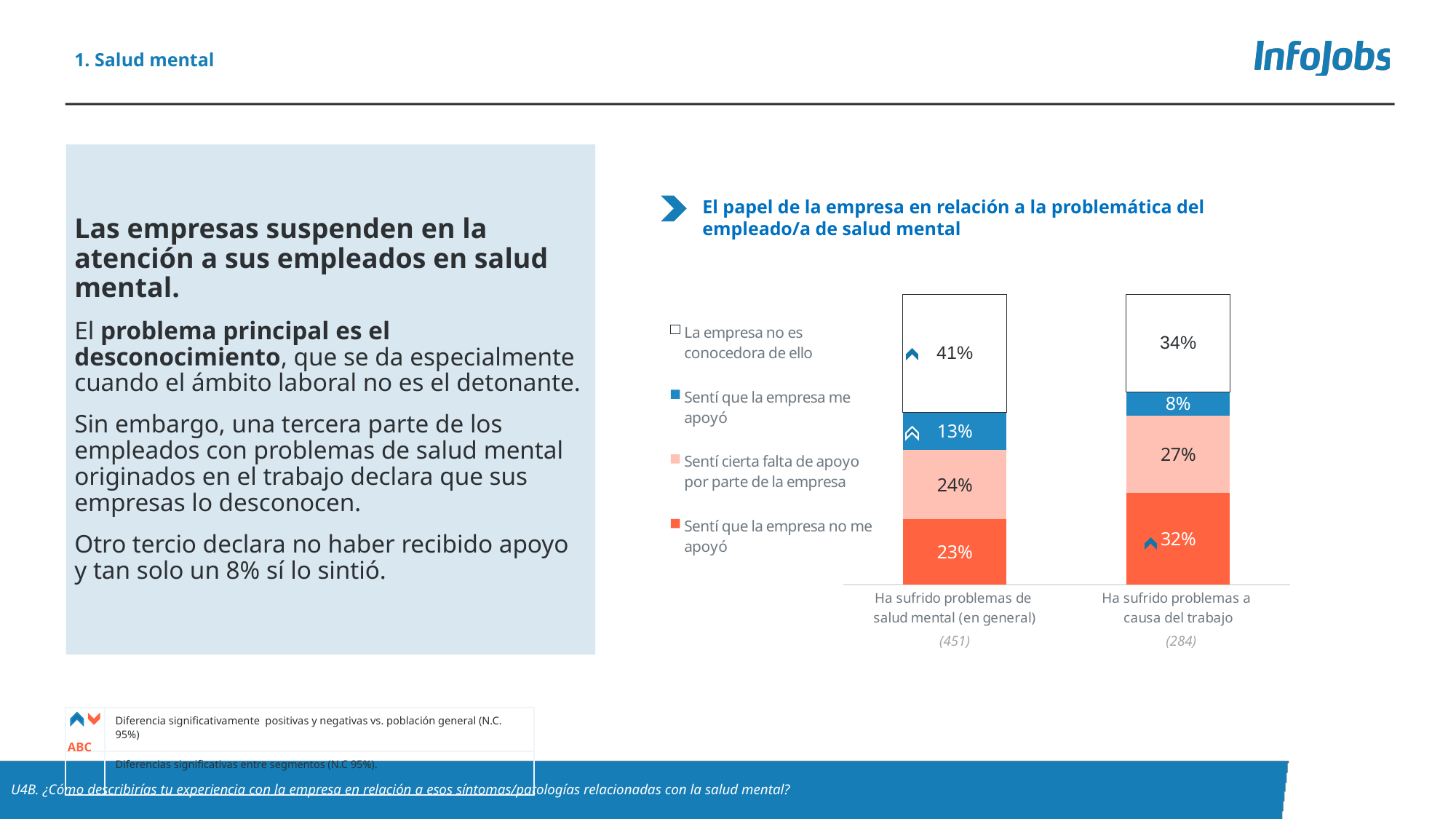
What kind of chart is shown on the slide? Stacked bar chart Which segment is the largest in the "Ha sufrido problemas a causa del trabajo" bar? La empresa no es conocedora de ello What is the value for "Sentí cierta falta de apoyo por parte de la empresa" in the "Ha sufrido problemas a causa del trabajo" bar? 27% What is the value for "Sentí que la empresa no me apoyó" in the "Ha sufrido problemas de salud mental (en general)" bar? 23% How many series does the legend list? 4 Which segment is the smallest in the "Ha sufrido problemas a causa del trabajo" bar? Sentí que la empresa me apoyó What percentage of those who have suffered problems caused by work said they felt the company supported them ("Sentí que la empresa me apoyó")? 8% How many categories (bars) are shown on the x axis? 2 What percentage of those who have suffered mental health problems in general said the company was not aware of it ("La empresa no es conocedora de ello")? 41% What is the sample size (n) shown under the "Ha sufrido problemas a causa del trabajo" bar? 284 What is the difference between the "Sentí que la empresa no me apoyó" values for the two bars? 9 percentage points Which bar has the higher value for "Sentí que la empresa me apoyó"? Ha sufrido problemas de salud mental (en general)